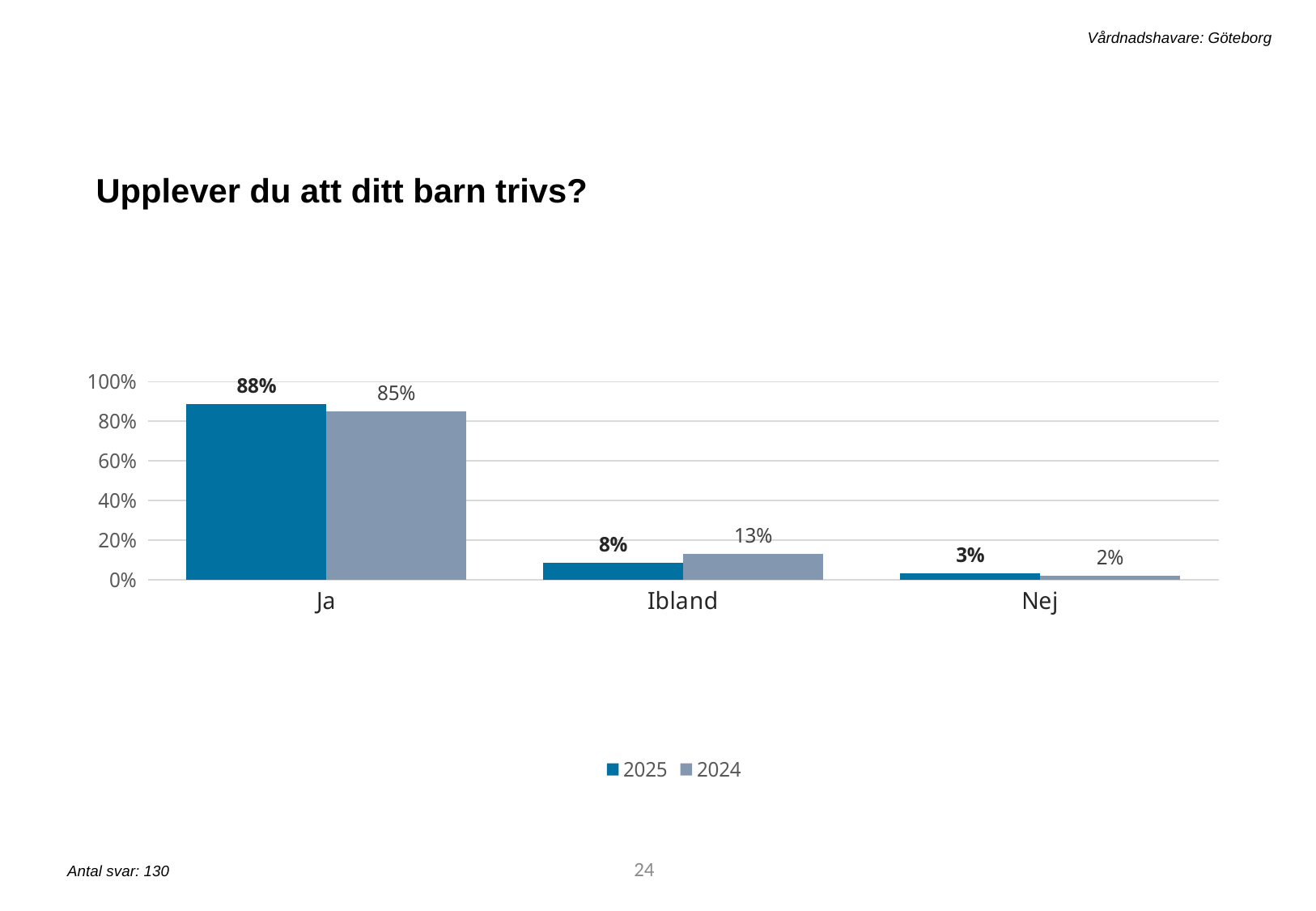
Which category has the highest value in the 2024 series? Ja What is the value for Ibland in the 2024 series? 13% What is the difference between the 2024 and 2025 values for Ibland? 5% How many series does the legend list? 2 What kind of chart is shown on the slide? bar chart What is the value for Ja in the 2025 series? 88% What is the difference between the 2025 and 2024 values for Ja? 3% What is the value for Nej in the 2025 series? 3% Is the 2024 value for Ja greater or less than 80%? greater How many categories are shown on the x axis? 3 Which category has the lowest value in the 2025 series? Nej Which is larger for Ibland, the 2025 value or the 2024 value? 2024